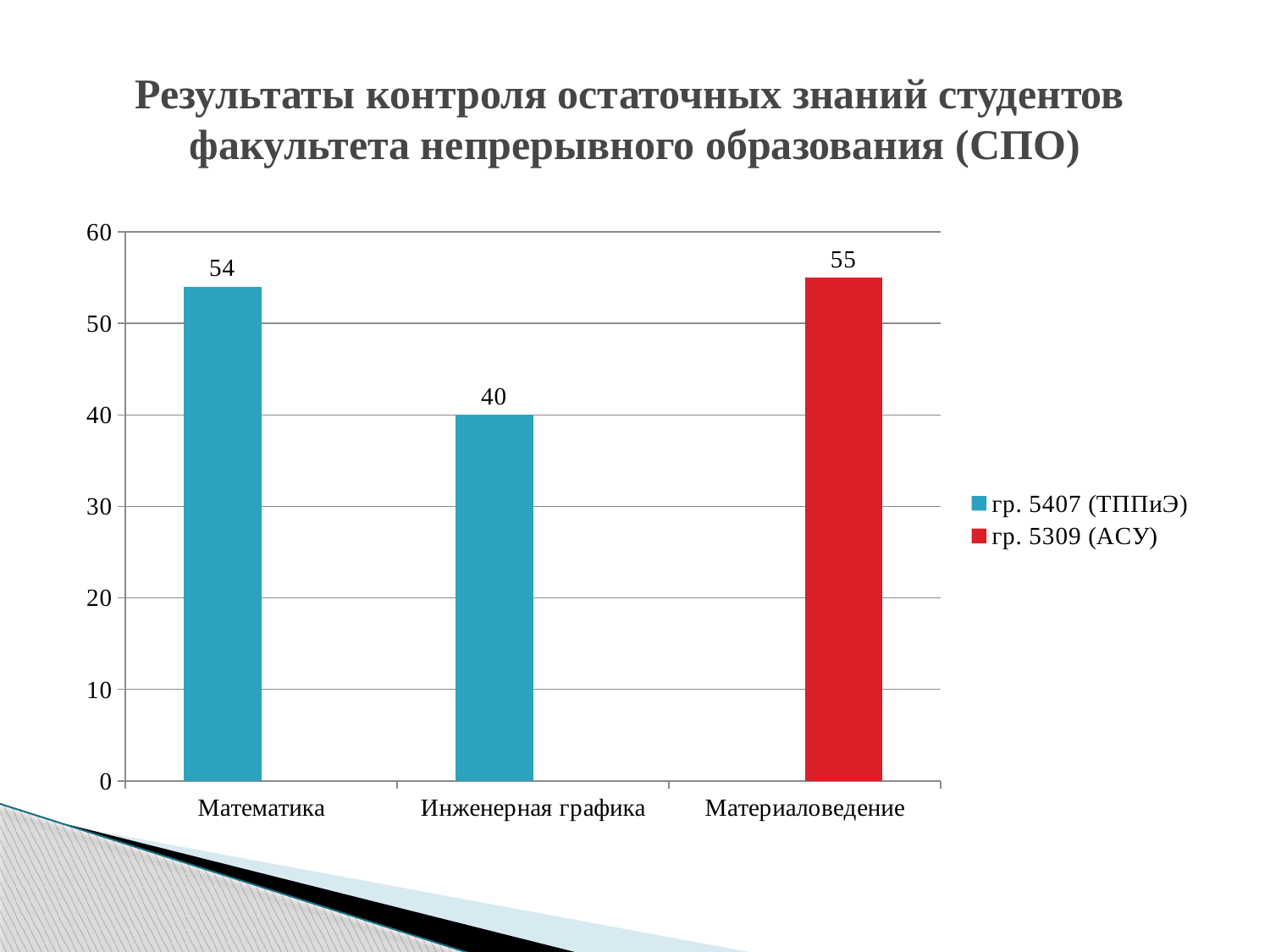
What is the value for Материаловедение? 55 What kind of chart is shown on the slide? bar chart What is the difference between the values for Материаловедение and Инженерная графика? 15 What is the difference between the values for Математика and Инженерная графика? 14 Which series does the red bar for Материаловедение belong to? гр. 5309 (АСУ) How many series does the legend list? 2 Is the value for Инженерная графика greater or less than 50? less Which category has the lowest value? Инженерная графика Which is larger, the value for Математика or the value for Инженерная графика? Математика How many categories are shown on the x axis? 3 What is the value for Математика? 54 What is the value for Инженерная графика? 40